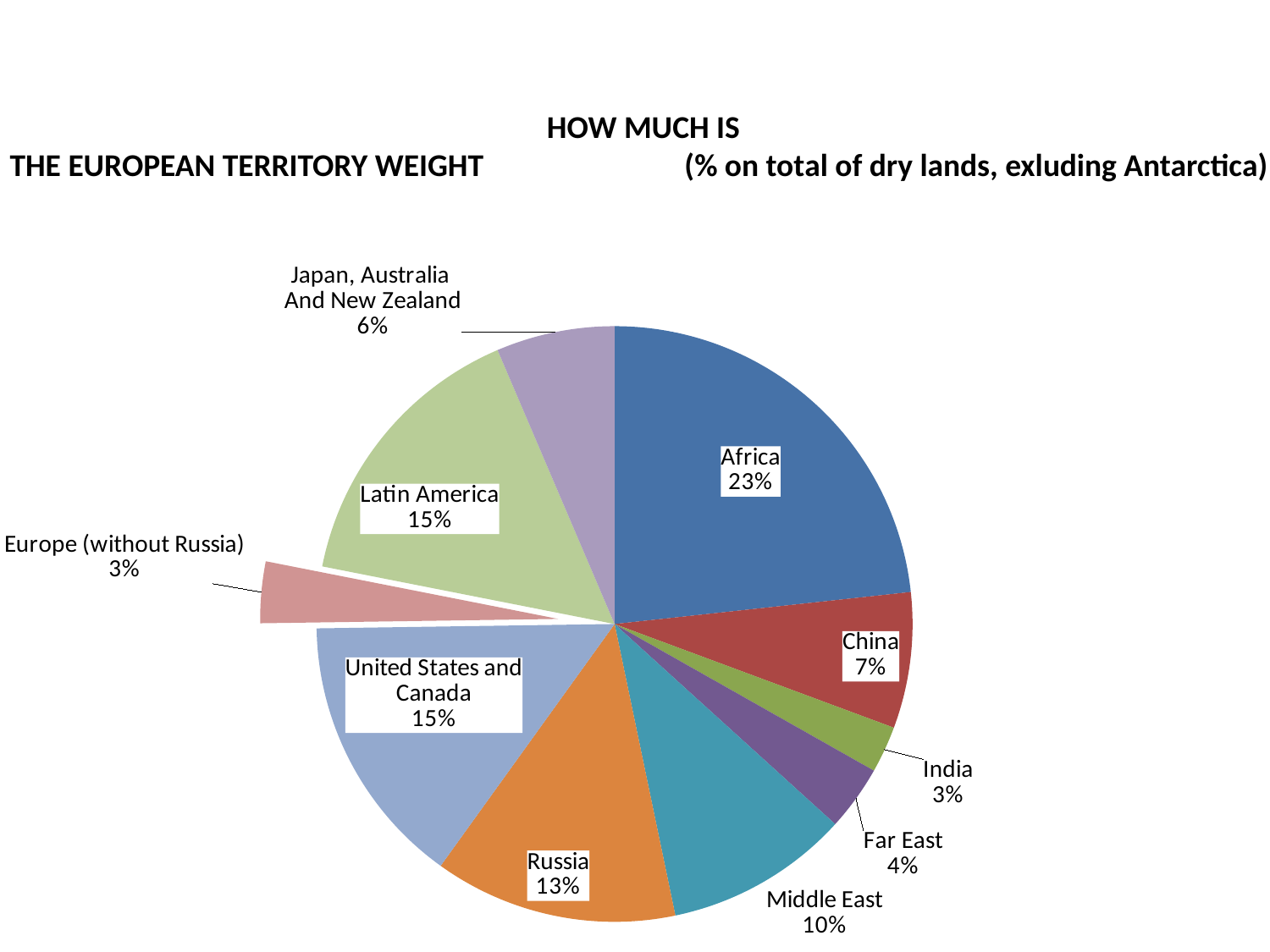
What is the value for Middle East? 10% What is the value shown for Russia? 13% What is the combined share of United States and Canada and Latin America? 30% How many slices does the pie chart have? 10 Which region has the largest slice of the pie? Africa Which is larger, the share for Russia or the share for Middle East? Russia What kind of chart is shown on the slide? Pie chart Which slice is pulled out (exploded) from the pie? Europe (without Russia) What is the value for Japan, Australia And New Zealand? 6% What share of the pie does Africa have? 23% What is the difference between the shares of Africa and China? 16% What percentage is shown for Europe (without Russia)? 3%